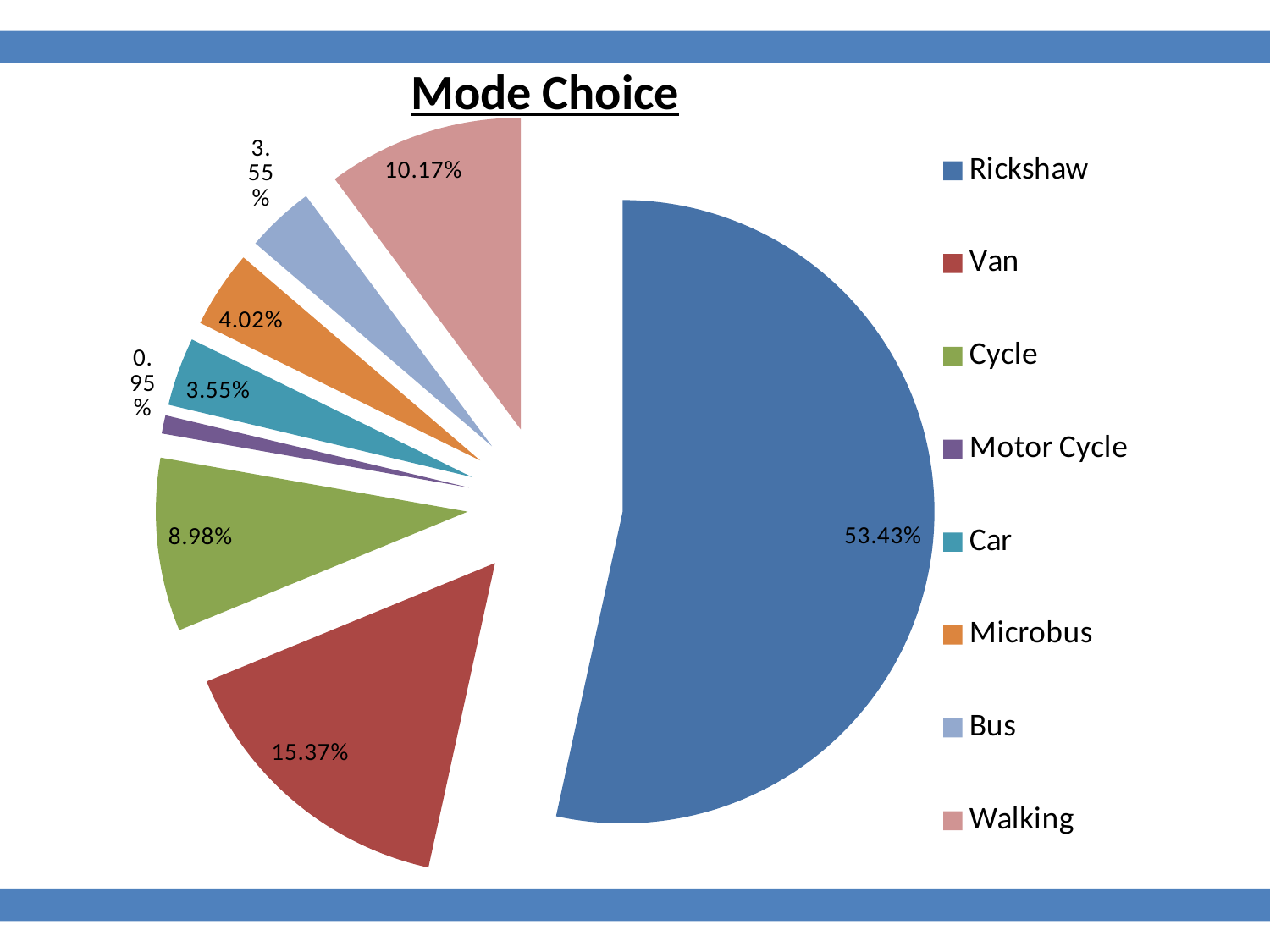
What share of the pie does Rickshaw account for? 53.43% Which mode has the smallest share of the pie? Motor Cycle Which mode has the largest share of the pie? Rickshaw How many categories does the legend list? 8 What is the title of the chart? Mode Choice What type of chart is shown on the slide? pie chart What is the value shown for Van? 15.37% Which is larger, the share for Van or the share for Walking? Van What is the value shown for Microbus? 4.02% What is the difference between the shares for Rickshaw and Van? 38.06% What is the value shown for Cycle? 8.98% What is the value shown for Walking? 10.17%